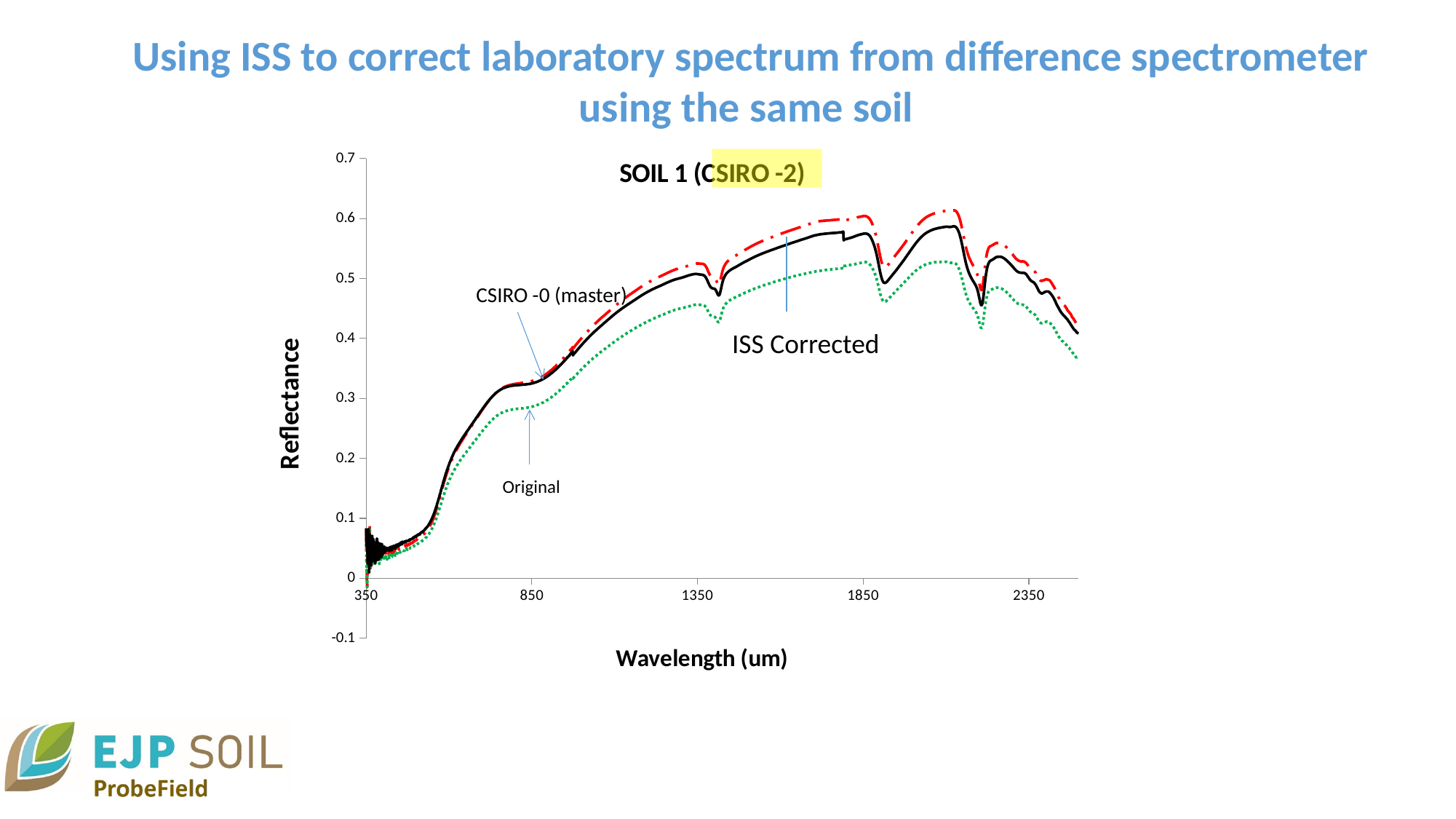
Is the value of the Original line at 1350 greater or less than 0.5? less What kind of chart is shown on the slide? line chart What is the title of the chart? SOIL 1 (CSIRO -2) Is the value of the Original line at 850 greater or less than 0.3? less How many spectra (lines) are plotted on the chart? 3 Is the value of the ISS Corrected line at 1350 greater or less than 0.5? greater At 1350, which line is higher: ISS Corrected or Original? ISS Corrected Which of the three lines has the lowest reflectance across most of the wavelength range? Original What is the label of the x axis? Wavelength (um) Does reflectance rise or fall between 350 and 850 along the x axis? rise